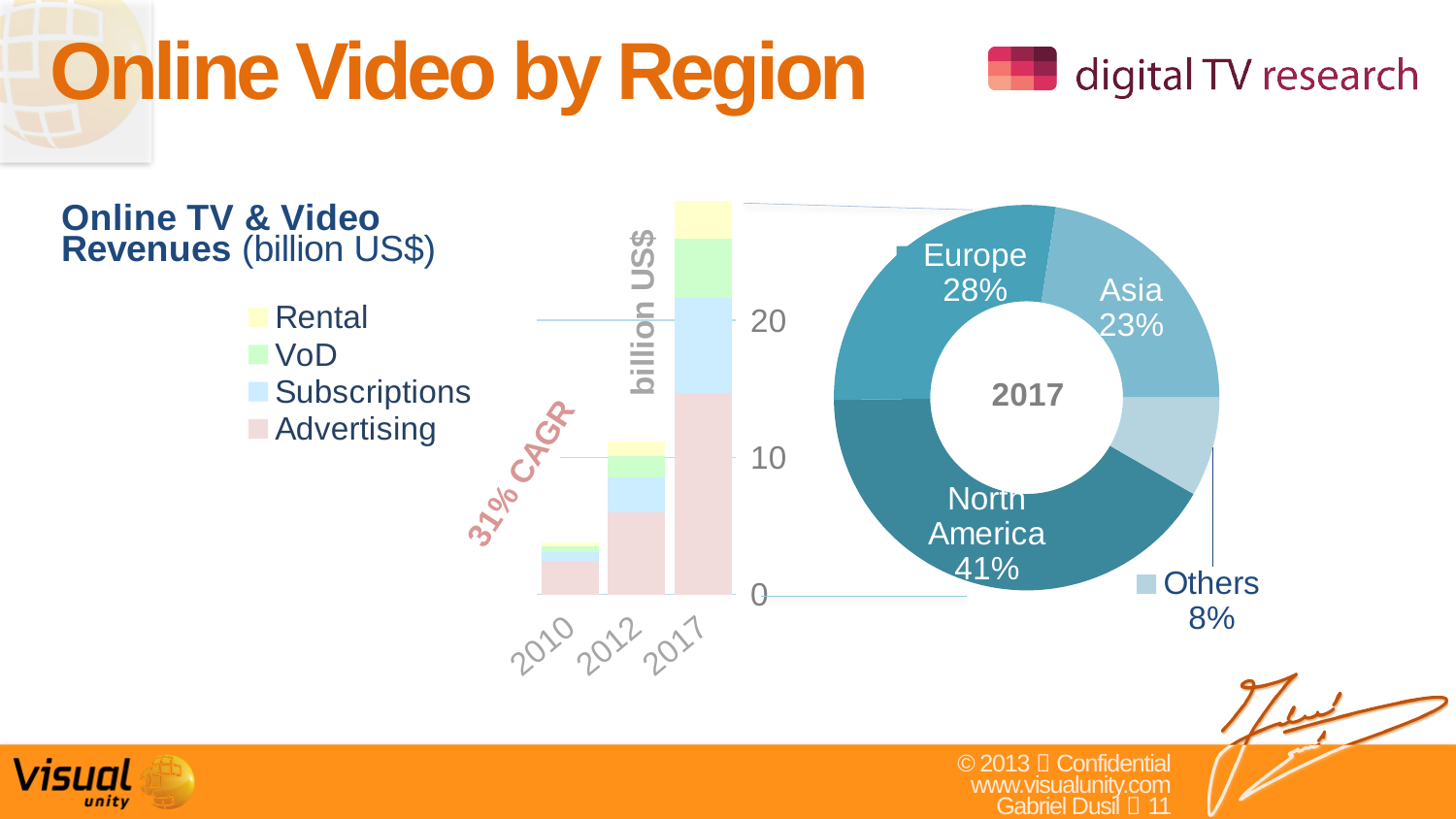
In the donut chart on the right, what share does North America have? 41% In the Online TV & Video Revenues bar chart, how many series does the legend list? 4 In the donut chart on the right, what share does Europe have? 28% In the donut chart on the right, how many percentage points larger is North America's share than Europe's? 13 In the donut chart on the right, which region has the smallest share? Others In the Online TV & Video Revenues bar chart, is the total for 2017 greater or less than 20 billion US$? greater In the donut chart on the right, which has the larger share, Europe or Asia? Europe In the donut chart on the right, what share does Asia have? 23% What kind of chart is the Online TV & Video Revenues chart? stacked bar chart In the donut chart on the right, which region has the largest share? North America In the donut chart on the right, which year does the chart represent? 2017 In the donut chart on the right, how many regions are shown? 4